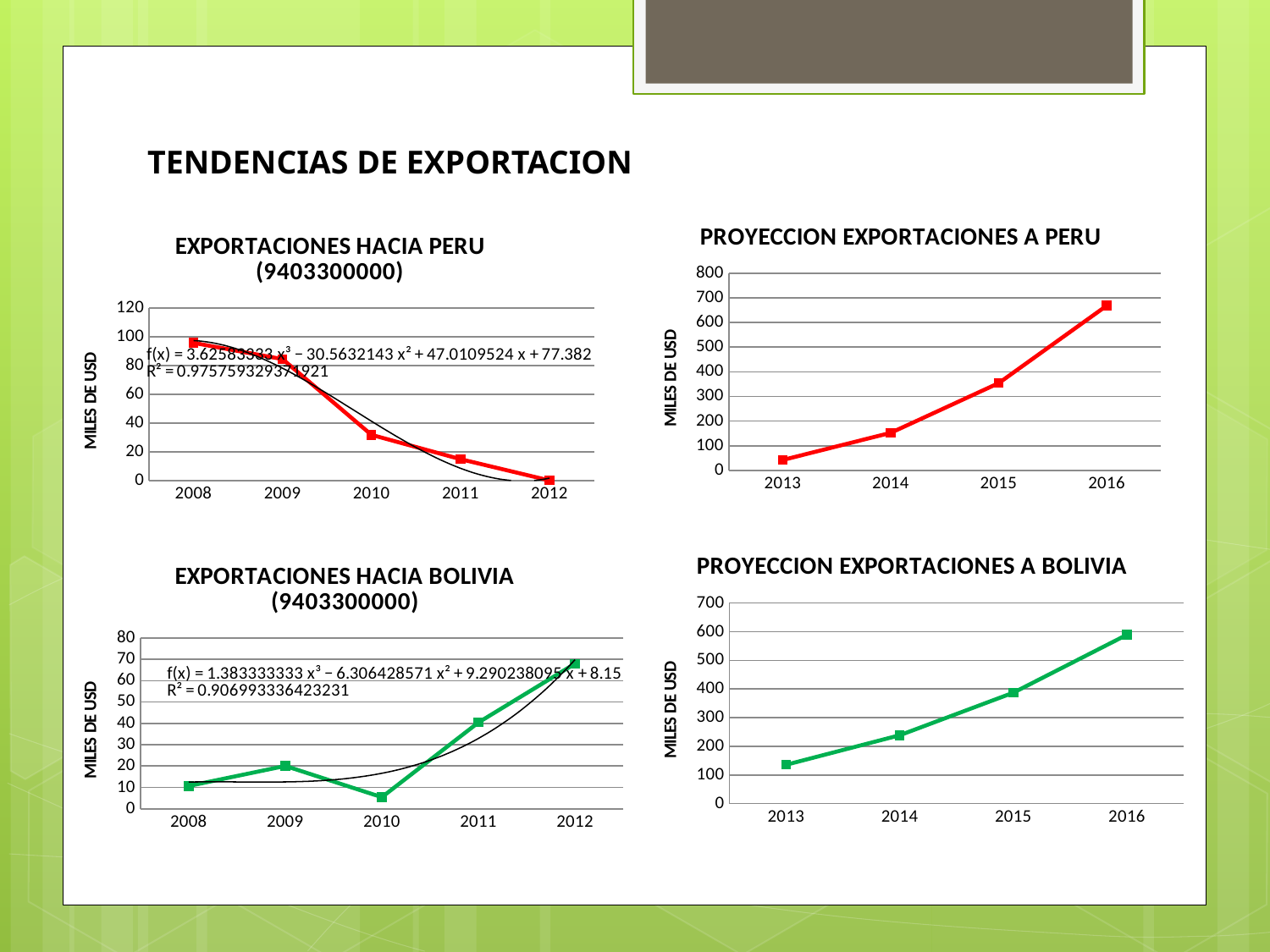
In the "EXPORTACIONES HACIA PERU (9403300000)" chart, is the value for 2010 greater or less than 40? less In the "EXPORTACIONES HACIA PERU (9403300000)" chart, which year has the highest value? 2008 In the "PROYECCION EXPORTACIONES A PERU" chart, which year has the highest value? 2016 In the "PROYECCION EXPORTACIONES A BOLIVIA" chart, do the values rise or fall from 2013 to 2016? Rise In the "EXPORTACIONES HACIA PERU (9403300000)" chart, do the values rise or fall from 2008 to 2012? Fall In the "EXPORTACIONES HACIA BOLIVIA (9403300000)" chart, which year has the lowest value? 2010 What kind of chart is the "EXPORTACIONES HACIA PERU (9403300000)" chart? Line chart In the "EXPORTACIONES HACIA BOLIVIA (9403300000)" chart, which year has the larger value, 2008 or 2012? 2012 In the "PROYECCION EXPORTACIONES A PERU" chart, is the value for 2016 greater or less than 600? greater What is the y-axis label on the "PROYECCION EXPORTACIONES A BOLIVIA" chart? MILES DE USD How many data points are plotted in the "PROYECCION EXPORTACIONES A PERU" chart? 4 In the "PROYECCION EXPORTACIONES A BOLIVIA" chart, is the value for 2013 greater or less than 100? greater